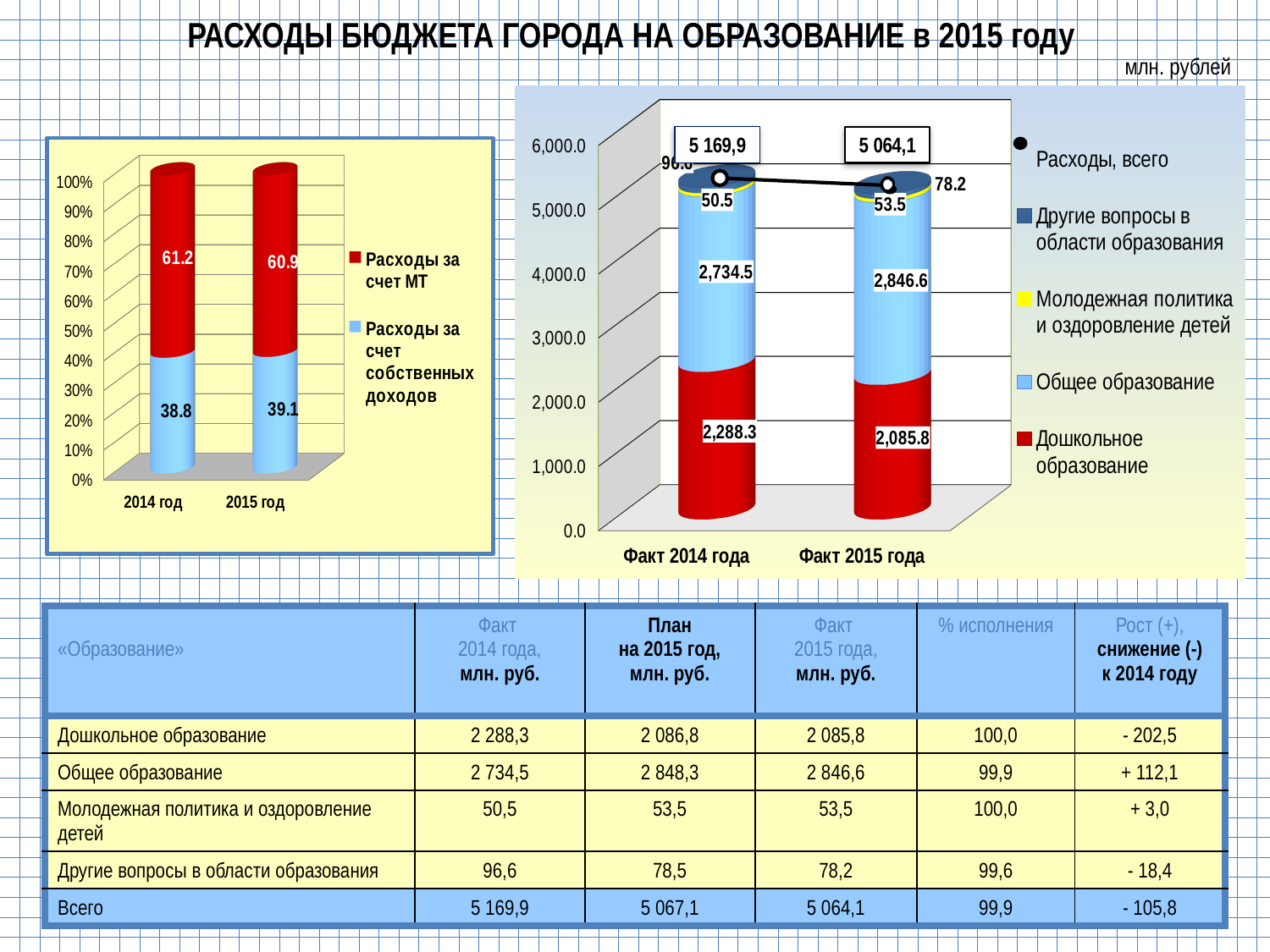
In the right chart, what is the value of «Общее образование» for Факт 2015 года? 2,846.6 What kind of chart is the right chart? stacked bar chart with a line In the right chart, what is the value of «Расходы, всего» for Факт 2015 года? 5 064,1 In the right chart, what is the value of «Дошкольное образование» for Факт 2014 года? 2,288.3 In the left chart, which year has the larger value for «Расходы за счет собственных доходов», 2014 год or 2015 год? 2015 год In the right chart, what is the difference between «Общее образование» for Факт 2015 года and Факт 2014 года? 112.1 In the right chart, what is the value of «Молодежная политика и оздоровление детей» for Факт 2014 года? 50.5 In the left chart, how many series does the legend list? 2 In the right chart, how many categories are shown on the x axis? 2 In the right chart, does «Расходы, всего» rise or fall from Факт 2014 года to Факт 2015 года? fall In the left chart, what is the value of «Расходы за счет собственных доходов» for 2015 год? 39.1 In the left chart, what is the value of «Расходы за счет МТ» for 2014 год? 61.2